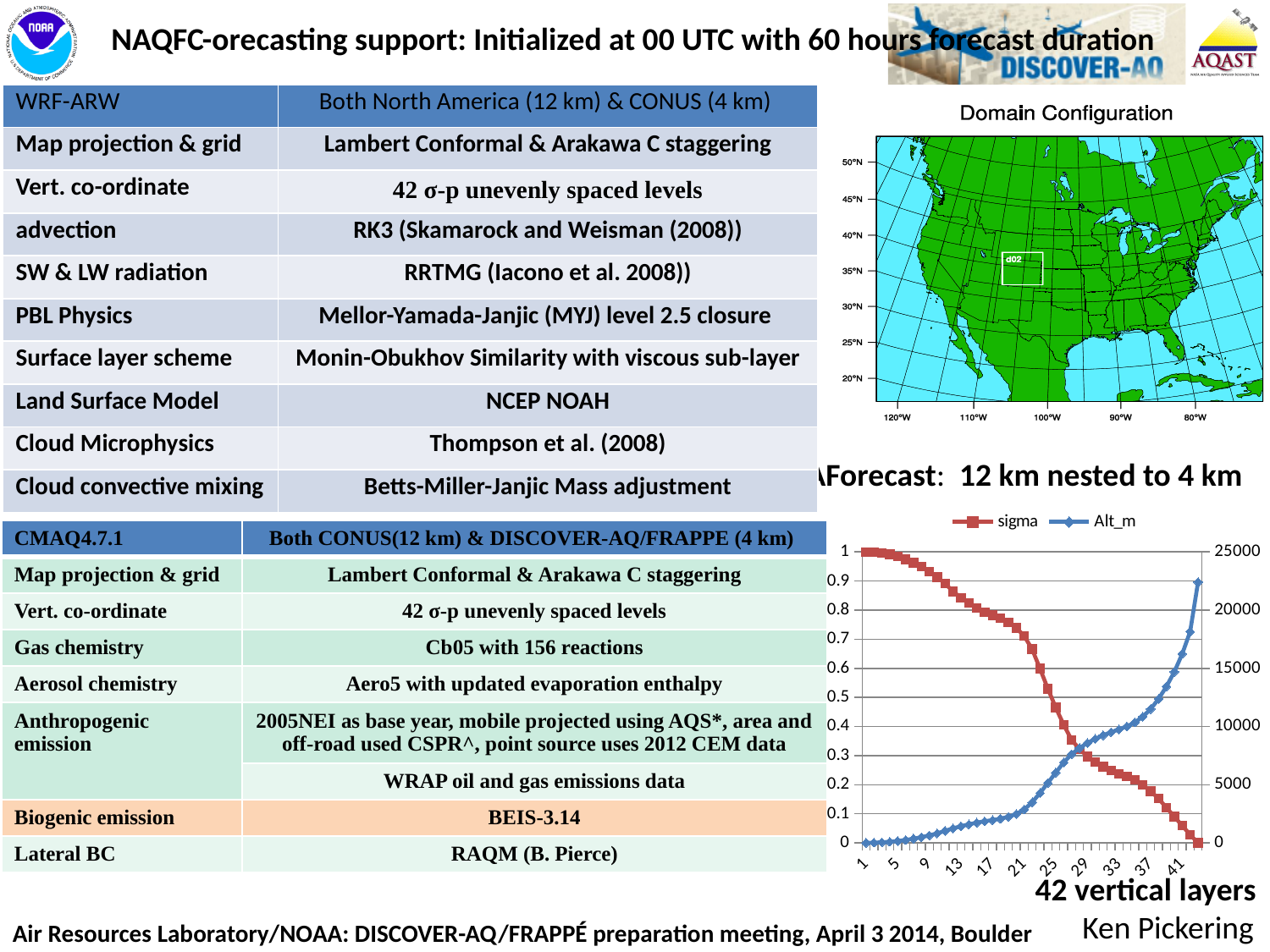
In the bottom-right chart, at which layer is the sigma series highest? 1 How many vertical layers are plotted in the bottom-right chart? 42 In the bottom-right chart, what is the sigma value at layer 1? 1 In the bottom-right chart, is the Alt_m value at layer 21 greater or less than 5000? less In the bottom-right chart, does the sigma series rise or fall as the layer number increases along the x axis? fall In the bottom-right chart, does the Alt_m series rise or fall as the layer number increases along the x axis? rise What are the two series named in the legend of the bottom-right chart? sigma and Alt_m How many series does the legend of the bottom-right chart list? 2 In the bottom-right chart, is the sigma value at layer 9 greater or less than 0.8? greater What kind of chart is shown at the bottom right of the slide? line chart In the bottom-right chart, is the Alt_m value at the last layer greater or less than 20000? greater